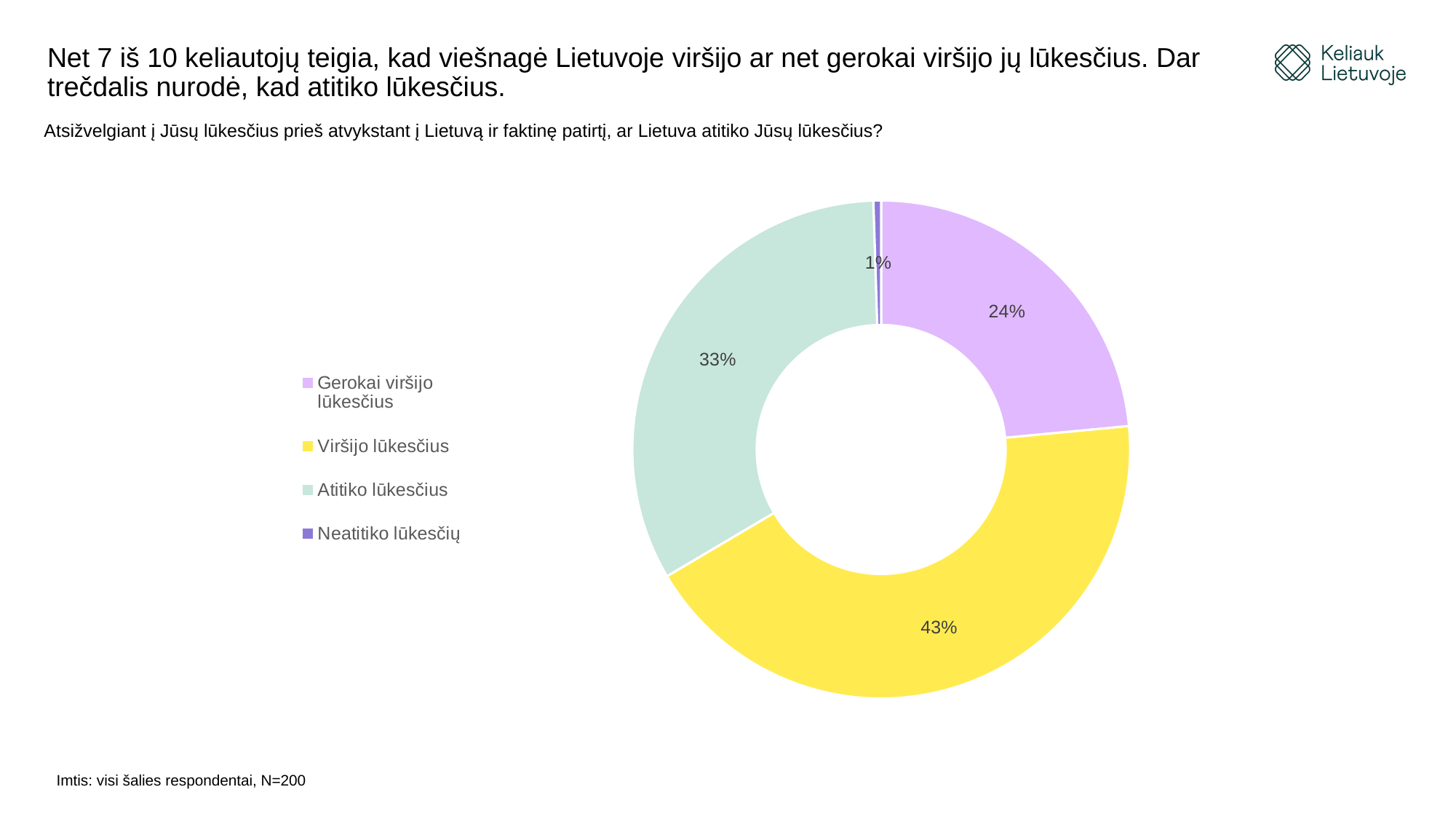
What is the combined share of "Gerokai viršijo lūkesčius" and "Viršijo lūkesčius"? 67% What kind of chart is shown on the slide? Pie chart (doughnut) What is the difference in percentage points between "Viršijo lūkesčius" and "Atitiko lūkesčius"? 10 What share of respondents answered "Neatitiko lūkesčių"? 1% How many categories does the pie chart show? 4 What share of respondents answered "Atitiko lūkesčius"? 33% Which category has the smallest share of the pie? Neatitiko lūkesčių What share of respondents answered "Gerokai viršijo lūkesčius"? 24% Which category has the largest share of the pie? Viršijo lūkesčius Which is larger: the share for "Atitiko lūkesčius" or the share for "Gerokai viršijo lūkesčius"? Atitiko lūkesčius What share of respondents answered "Viršijo lūkesčius"? 43% What colour represents "Atitiko lūkesčius" in the chart? Light green